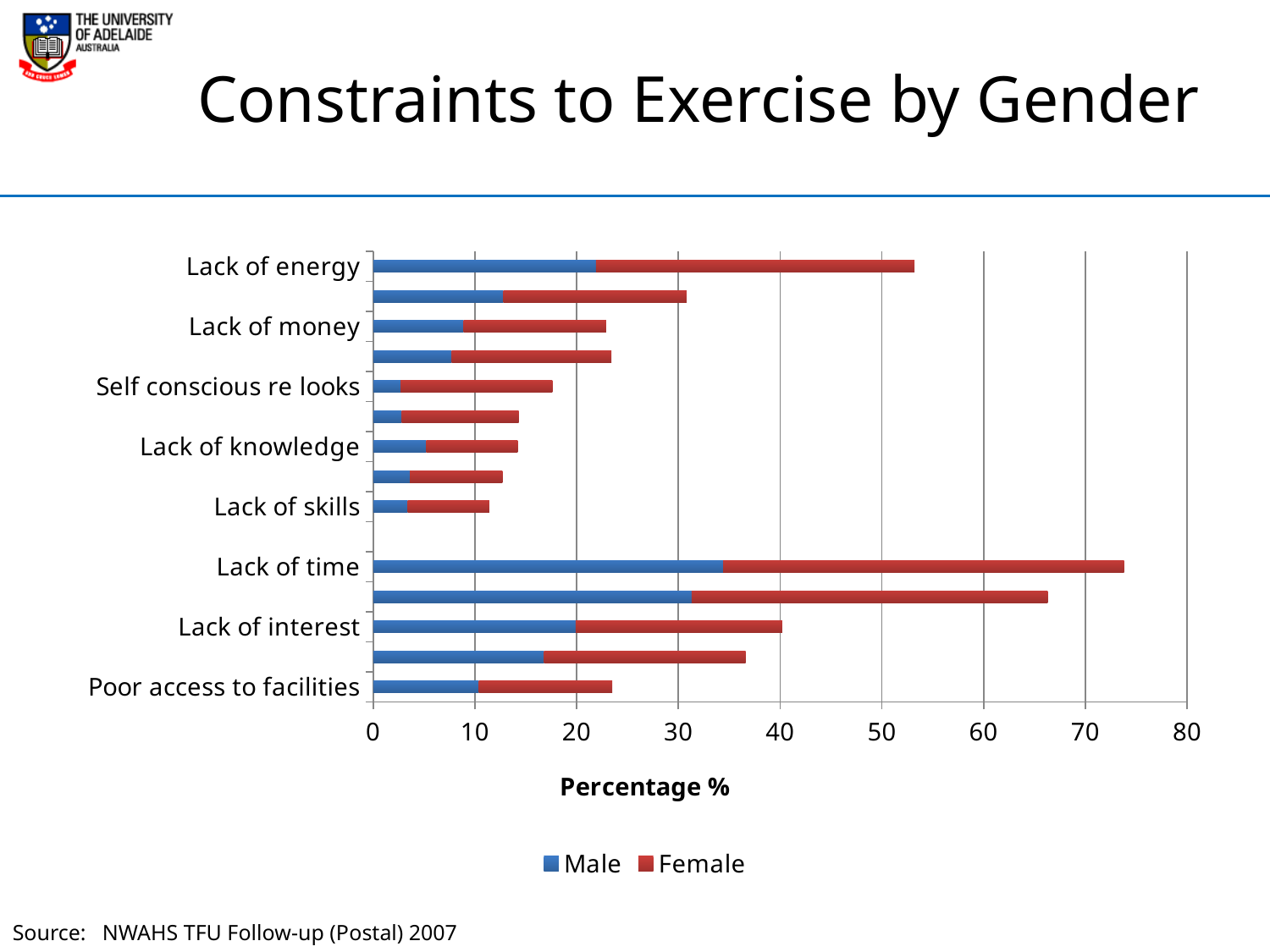
Which has the longer total bar, Lack of energy or Lack of interest? Lack of energy Is the Male portion of the Lack of time bar greater or less than 30? greater How many series does the legend list? 2 Is the total bar for Lack of time greater or less than 70? greater Which constraint has the longest bar overall? Lack of time What is the title of the horizontal axis? Percentage % Is the total bar for Lack of interest greater or less than 50? less Which has the longer total bar, Self conscious re looks or Lack of knowledge? Self conscious re looks What kind of chart is shown on the slide? bar chart In the Lack of energy bar, which segment is longer, Male or Female? Female